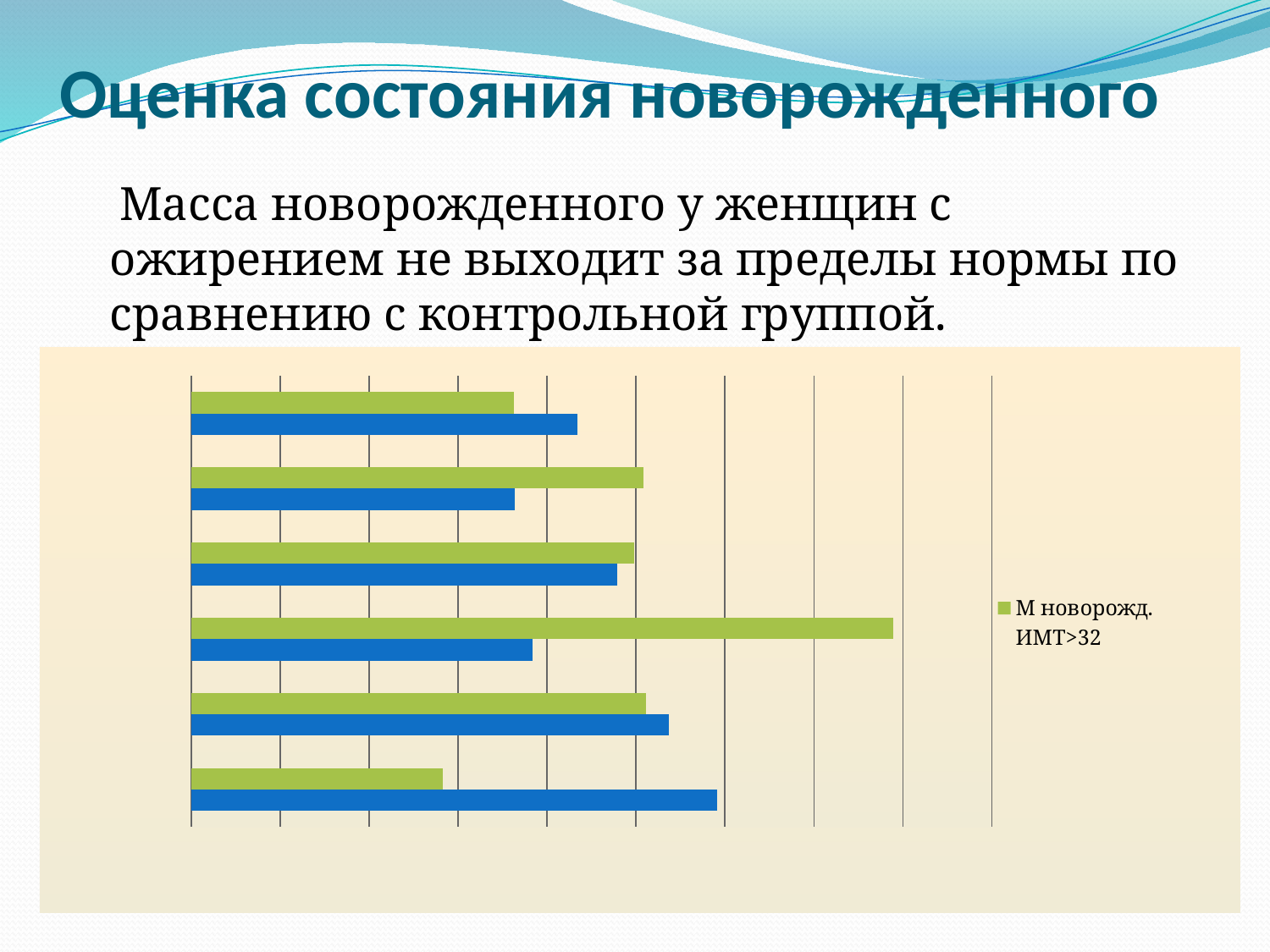
In the bottom group of bars, which bar is longer, the green one or the blue one? blue What kind of chart is shown on the slide? bar chart What colour represents the series "М новорожд. ИМТ>32" in the legend? green Which group of bars, counted from the top, contains the shortest green bar? sixth Which group of bars, counted from the top, contains the longest green bar? fourth How many groups of bars (categories) are plotted in the chart? 6 How many series does the chart legend list? 1 In the fourth group of bars from the top, which bar is longer, the green one or the blue one? green What is the legend entry shown in the chart? М новорожд. ИМТ>32